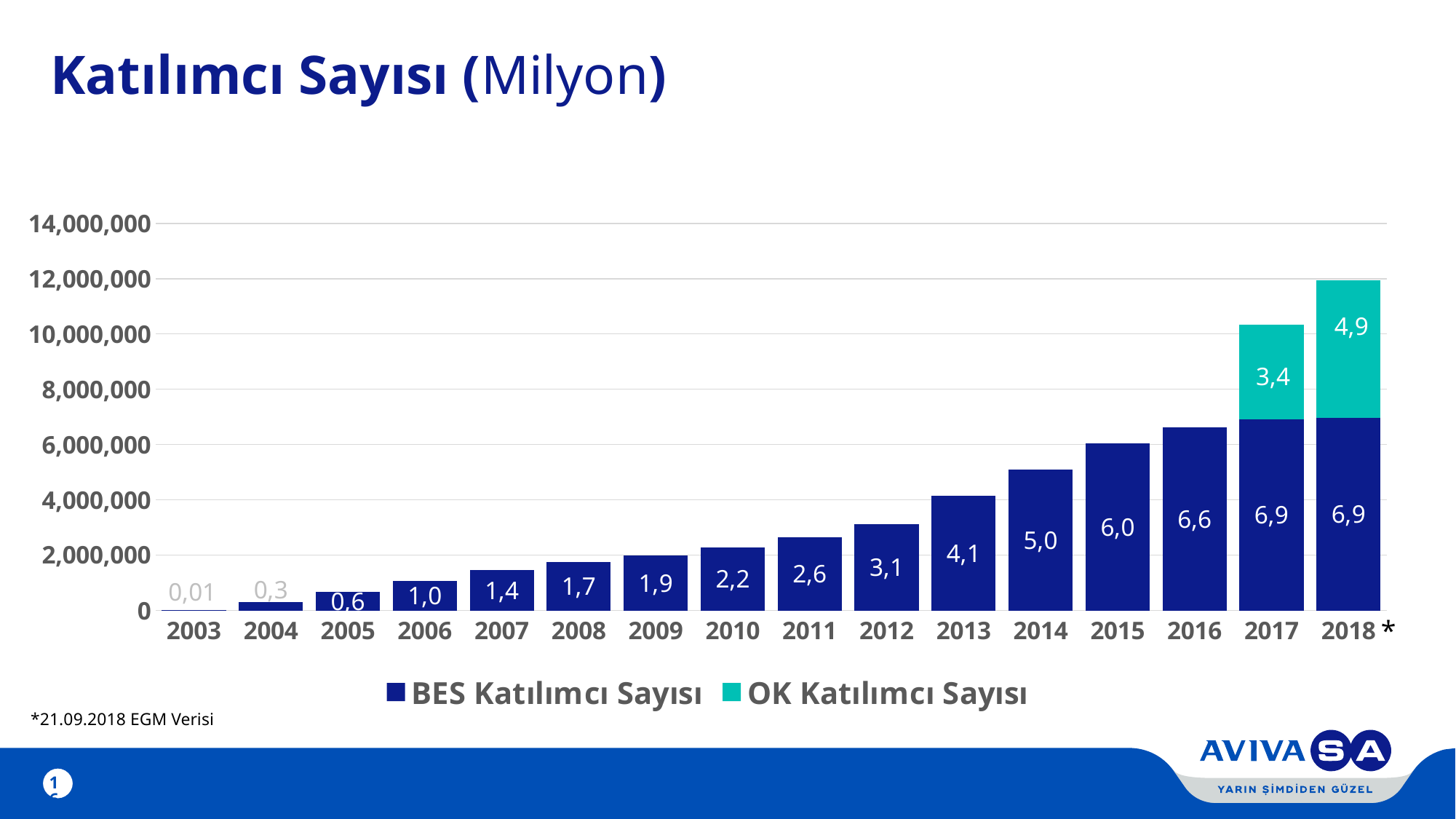
What is the BES Katılımcı Sayısı value for 2009? 1,9 How many series does the legend list? 2 Which year has the lowest BES Katılımcı Sayısı value? 2003 What is the BES Katılımcı Sayısı value for 2014? 5,0 What is the difference between the BES Katılımcı Sayısı values for 2016 and 2015? 0,6 What kind of chart is shown on the slide? Stacked bar chart What is the OK Katılımcı Sayısı value for 2017? 3,4 Which is larger, the OK Katılımcı Sayısı value for 2018 or for 2017? 2018 What is the OK Katılımcı Sayısı value for 2018? 4,9 What is the total of the stacked bar for 2017 (BES plus OK), in millions? 10,3 What is the total of the stacked bar for 2018 (BES plus OK), in millions? 11,9 How many years are shown on the x axis? 16